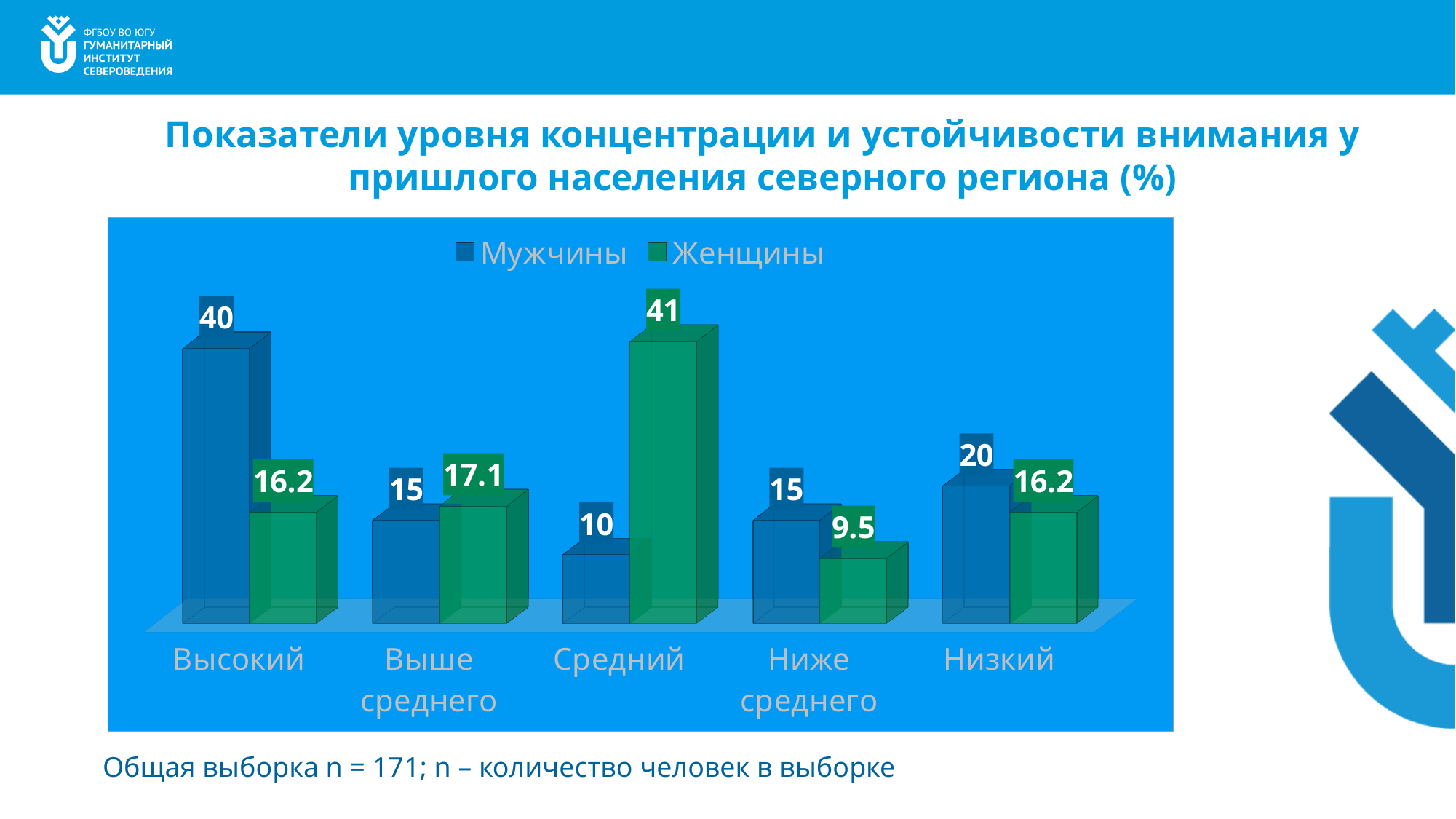
What is the value for Женщины in the Ниже среднего category? 9.5 In which category is the Мужчины value highest? Высокий What is the difference between the Женщины and Мужчины values in the Средний category? 31 How many series does the legend list? 2 What colour are the bars for the Женщины series? Green What kind of chart is shown on the slide? Bar chart How many categories are shown on the x axis? 5 What is the value for Мужчины in the Низкий category? 20 What is the value for Мужчины in the Высокий category? 40 What is the value for Женщины in the Средний category? 41 In which category is the Женщины value lowest? Ниже среднего In the Выше среднего category, which series has the larger value, Мужчины or Женщины? Женщины